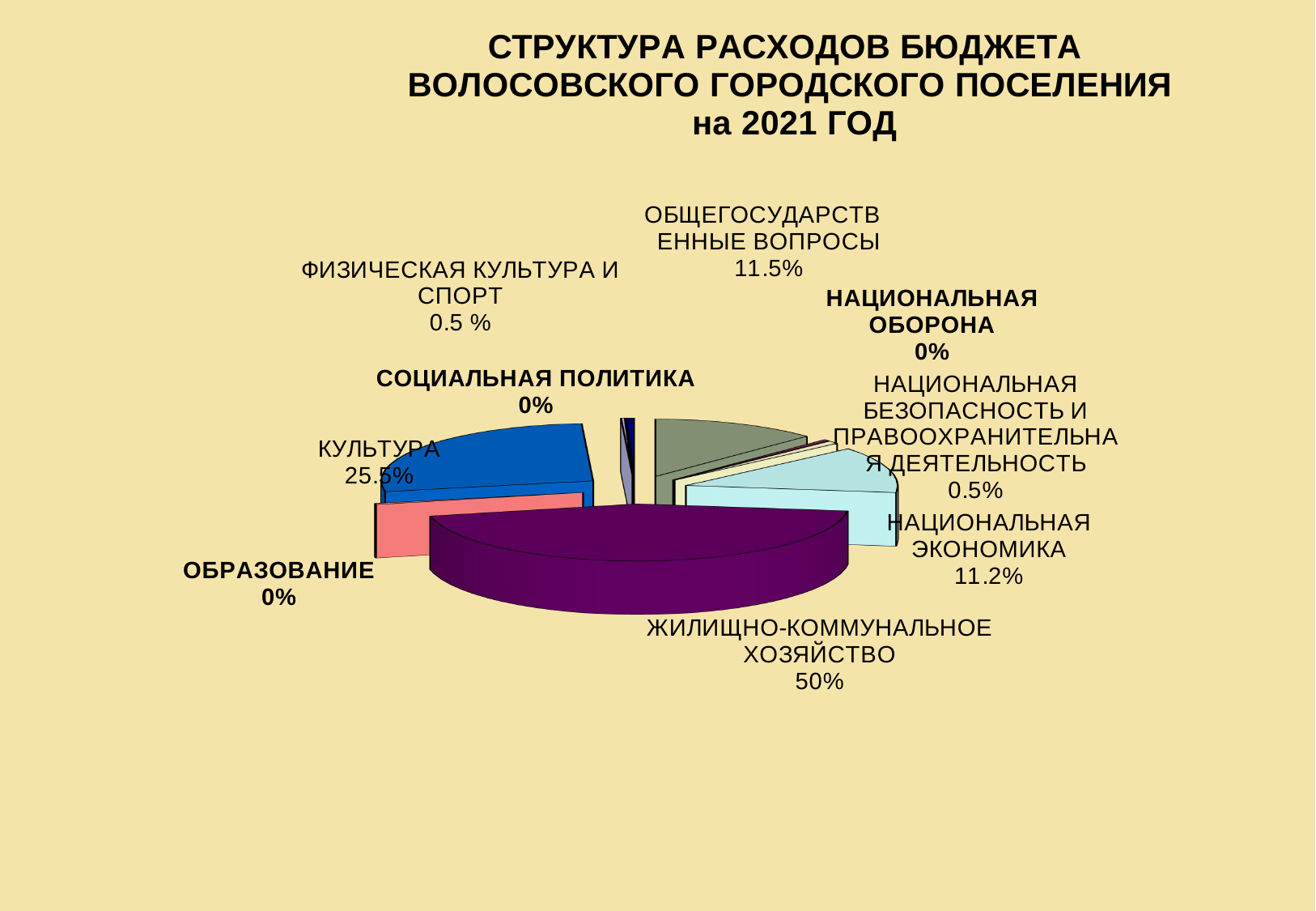
What is the value shown for НАЦИОНАЛЬНАЯ ОБОРОНА? 0% What is the value shown for НАЦИОНАЛЬНАЯ ЭКОНОМИКА? 11.2% What kind of chart is shown on the slide? pie chart What is the value shown for ФИЗИЧЕСКАЯ КУЛЬТУРА И СПОРТ? 0.5 % Which category has the largest share of the pie? ЖИЛИЩНО-КОММУНАЛЬНОЕ ХОЗЯЙСТВО How many categories are labelled on the pie chart? 9 Which year does the chart title say the budget expenditure structure is for? 2021 What is the value shown for КУЛЬТУРА? 25.5% Which is larger, the share for ОБЩЕГОСУДАРСТВЕННЫЕ ВОПРОСЫ or for НАЦИОНАЛЬНАЯ ЭКОНОМИКА? ОБЩЕГОСУДАРСТВЕННЫЕ ВОПРОСЫ What share of the budget expenditure goes to ЖИЛИЩНО-КОММУНАЛЬНОЕ ХОЗЯЙСТВО? 50% What is the difference between the shares of ЖИЛИЩНО-КОММУНАЛЬНОЕ ХОЗЯЙСТВО and КУЛЬТУРА? 24.5% What is the value shown for ОБЩЕГОСУДАРСТВЕННЫЕ ВОПРОСЫ? 11.5%